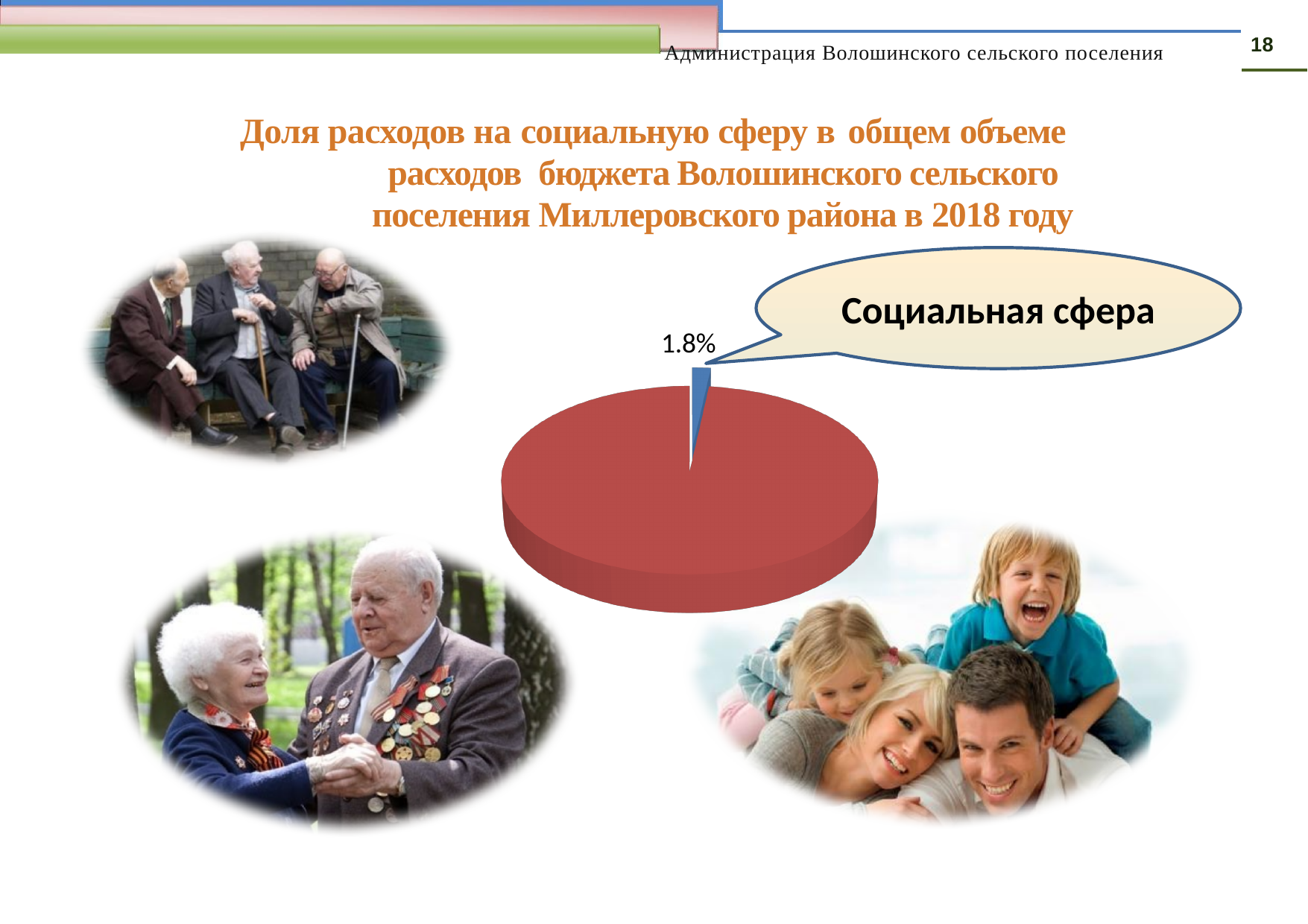
How many slices does the pie chart have? 2 What kind of chart is shown on the slide? pie chart What value is printed on the small blue slice of the pie chart? 1.8% What share of the pie is labelled for "Социальная сфера"? 1.8% Which slice is larger, the red slice or the blue slice labelled 1.8%? the red slice Which year does the chart title say the expenditure share refers to? 2018 What colour is the slice representing "Социальная сфера"? blue Which slice of the pie chart is the smallest? Социальная сфера (1.8%)